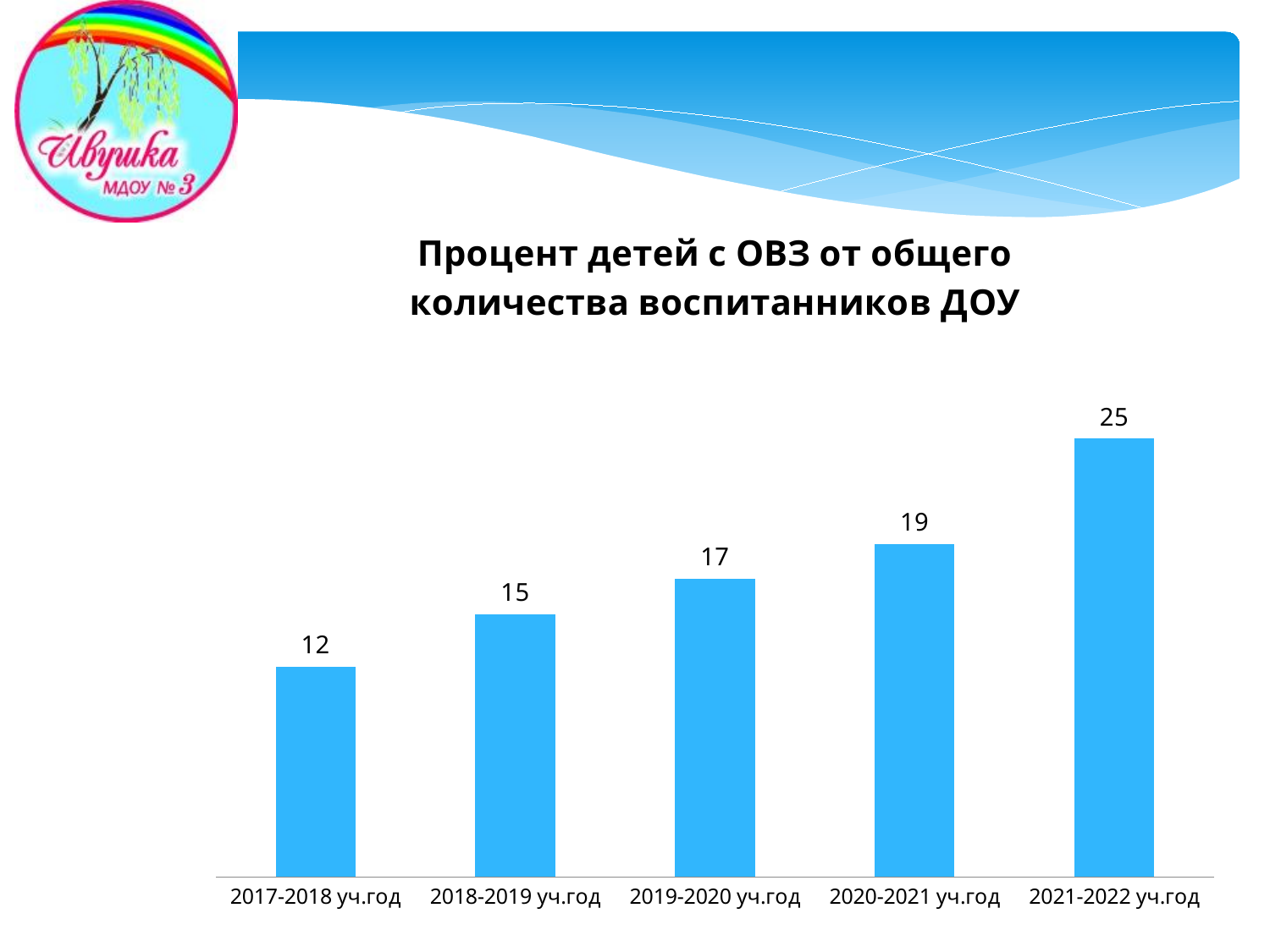
What is the value for 2021-2022 уч.год? 25 How many academic years are shown on the chart? 5 Which academic year has the highest value? 2021-2022 уч.год Do the values rise or fall from 2017-2018 уч.год to 2021-2022 уч.год? rise Which academic year has the lowest value? 2017-2018 уч.год What is the value for 2017-2018 уч.год? 12 What is the title of the chart? Процент детей с ОВЗ от общего количества воспитанников ДОУ What is the difference between the values for 2020-2021 уч.год and 2018-2019 уч.год? 4 What kind of chart is shown on the slide? bar chart Which is larger, the value for 2018-2019 уч.год or the value for 2020-2021 уч.год? 2020-2021 уч.год What is the value for 2019-2020 уч.год? 17 What is the difference between the values for 2021-2022 уч.год and 2017-2018 уч.год? 13